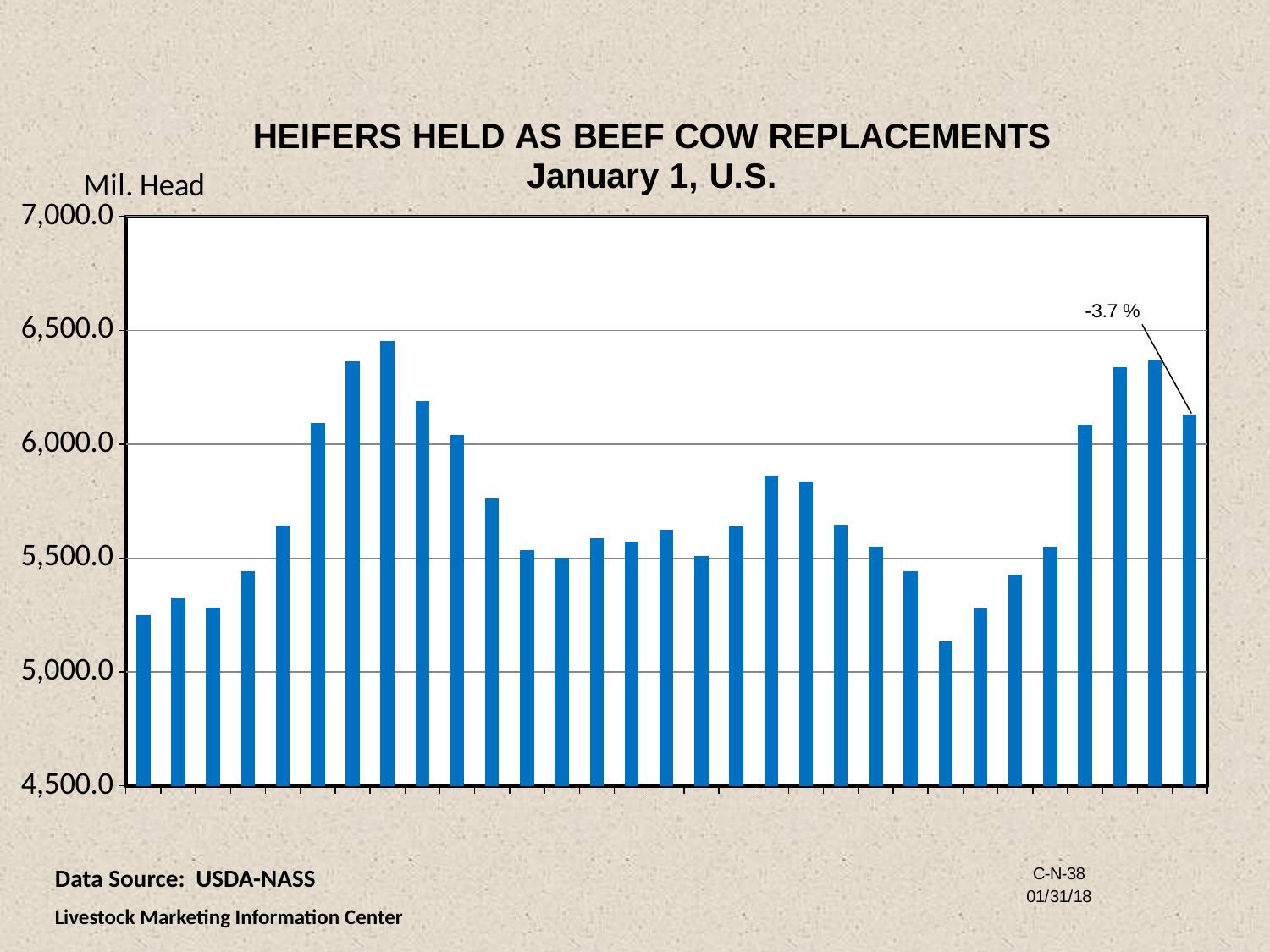
From the shortest bar to the second-to-last bar, do the values rise or fall? rise What is the title of the chart? HEIFERS HELD AS BEEF COW REPLACEMENTS January 1, U.S. What percentage change is annotated next to the last bar of the chart? -3.7 % What kind of chart is shown on the slide? bar chart Is the value of the shortest bar greater or less than 5,500? less Is the value of the last (rightmost) bar greater or less than 6,000? greater Is the value of the tallest bar greater or less than the value of the last bar? greater Which is larger, the last bar or the second-to-last bar? the second-to-last bar Over the three bars immediately following the tallest bar, do the values rise or fall? fall Is the value of the tallest bar greater or less than 6,000? greater How many bars are plotted in the chart? 31